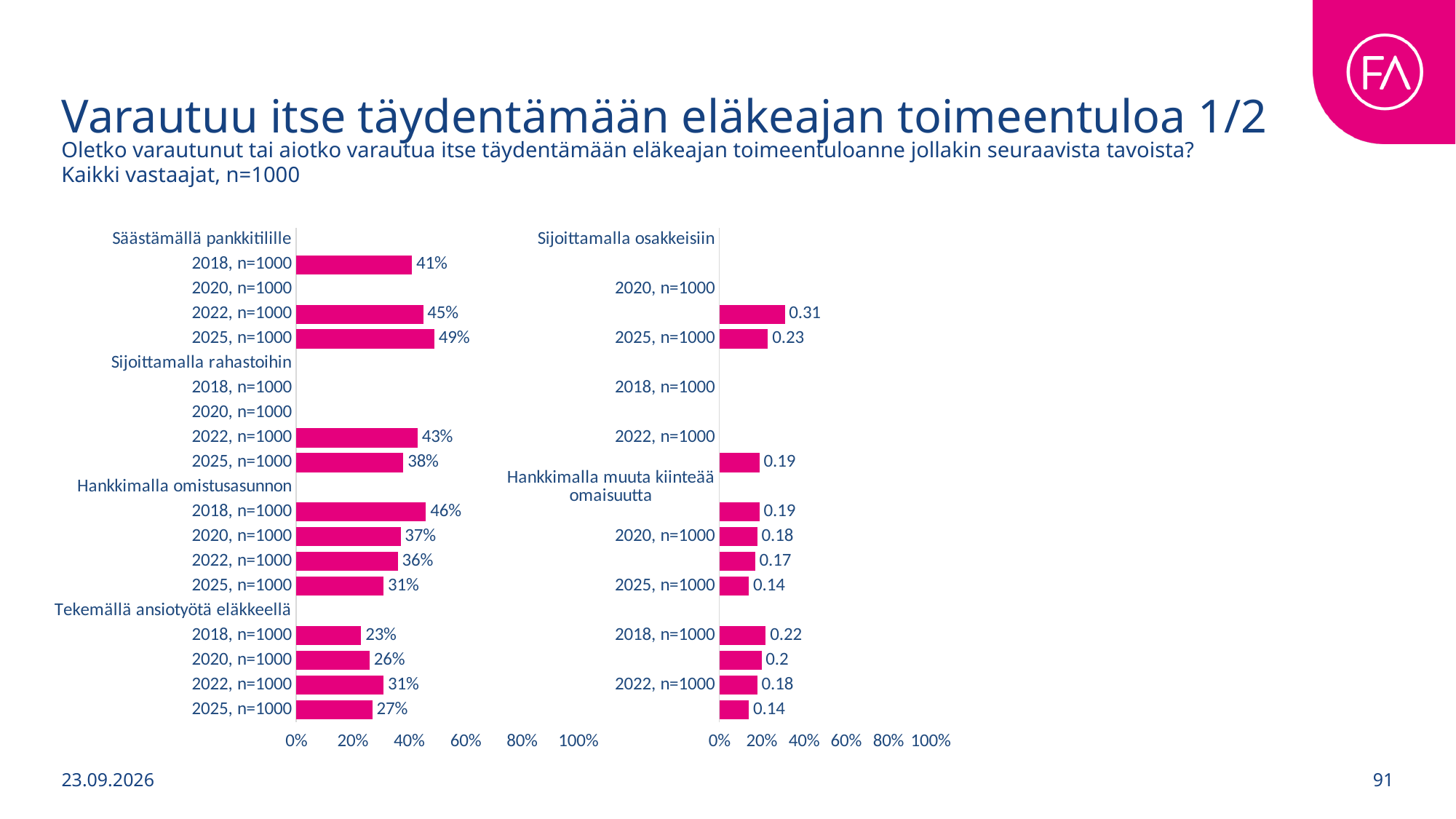
In the left chart, which is larger: Sijoittamalla rahastoihin in 2022 or Hankkimalla omistusasunnon in 2022? Sijoittamalla rahastoihin in 2022 In the left chart, what is the value for Tekemällä ansiotyötä eläkkeellä in 2018, n=1000? 23% In the left chart, which year has the lowest value under Tekemällä ansiotyötä eläkkeellä? 2018, n=1000 In the right chart, what is the difference between the 2020 and 2025 values for Hankkimalla muuta kiinteää omaisuutta? 0.04 In the left chart, which year has the highest value under Hankkimalla omistusasunnon? 2018, n=1000 What kind of chart is shown on the left of the slide? bar chart In the left chart, what is the value for Sijoittamalla rahastoihin in 2022, n=1000? 43% In the left chart, do the values for Hankkimalla omistusasunnon rise or fall from 2018 to 2025? fall In the left chart, what is the value for Säästämällä pankkitilille in 2025, n=1000? 49% In the right chart, what is the value for Hankkimalla muuta kiinteää omaisuutta in 2020, n=1000? 0.18 In the right chart, what is the value for Sijoittamalla osakkeisiin in 2025, n=1000? 0.23 In the left chart, what is the difference between the 2025 and 2018 values for Säästämällä pankkitilille? 8%